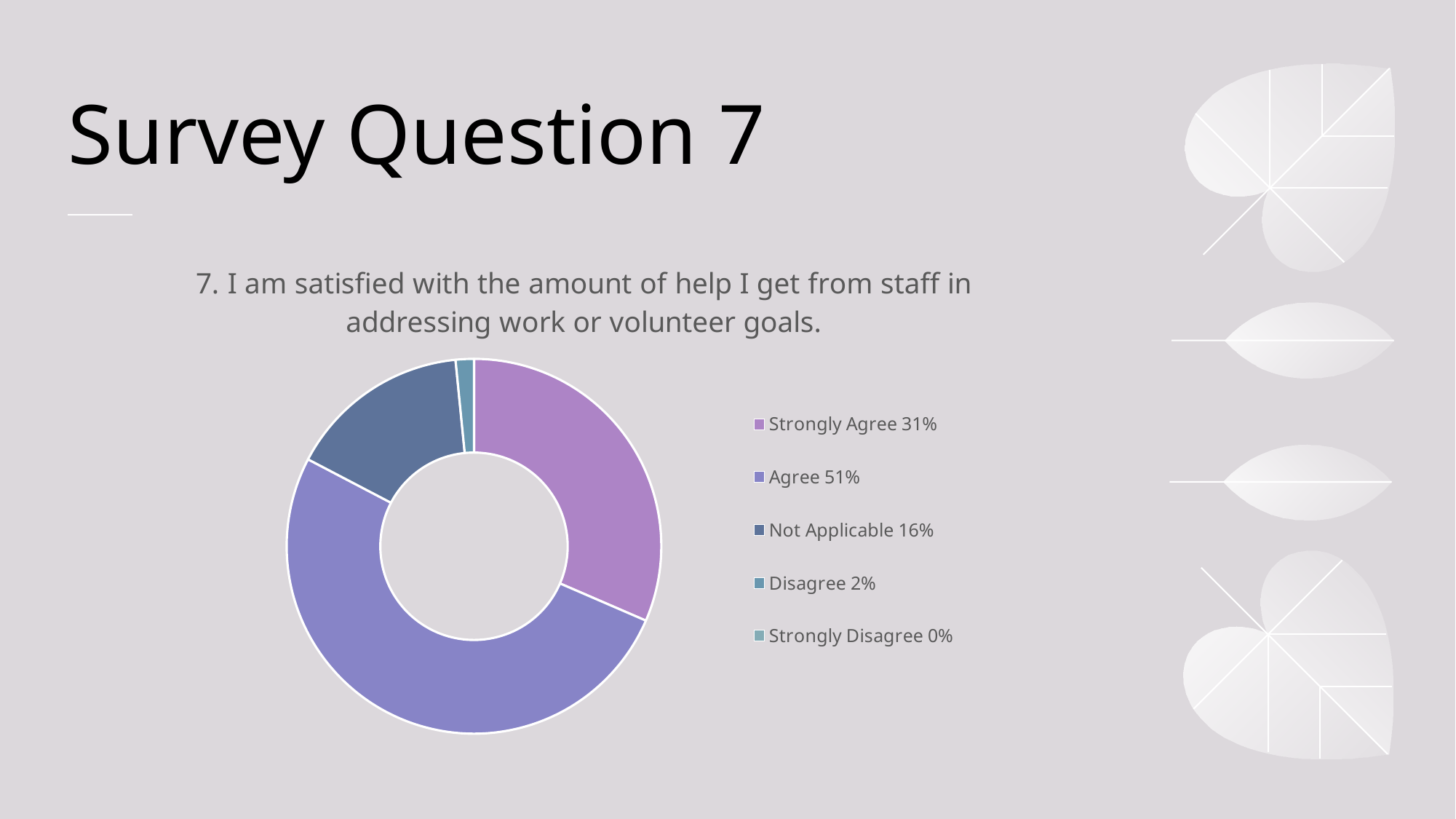
Which is larger, the share for Not Applicable or the share for Disagree? Not Applicable Which response category has the largest share? Agree What percentage of respondents answered Strongly Agree? 31% What kind of chart is shown on the slide? Doughnut (pie) chart What is the combined share of Strongly Agree and Agree? 82% What percentage of respondents answered Not Applicable? 16% How many response categories does the legend list? 5 What percentage of respondents answered Agree? 51% Which response category has the smallest share? Strongly Disagree What percentage of respondents answered Disagree? 2% What is the difference in percentage points between Agree and Strongly Agree? 20 What survey question does the chart illustrate? 7. I am satisfied with the amount of help I get from staff in addressing work or volunteer goals.